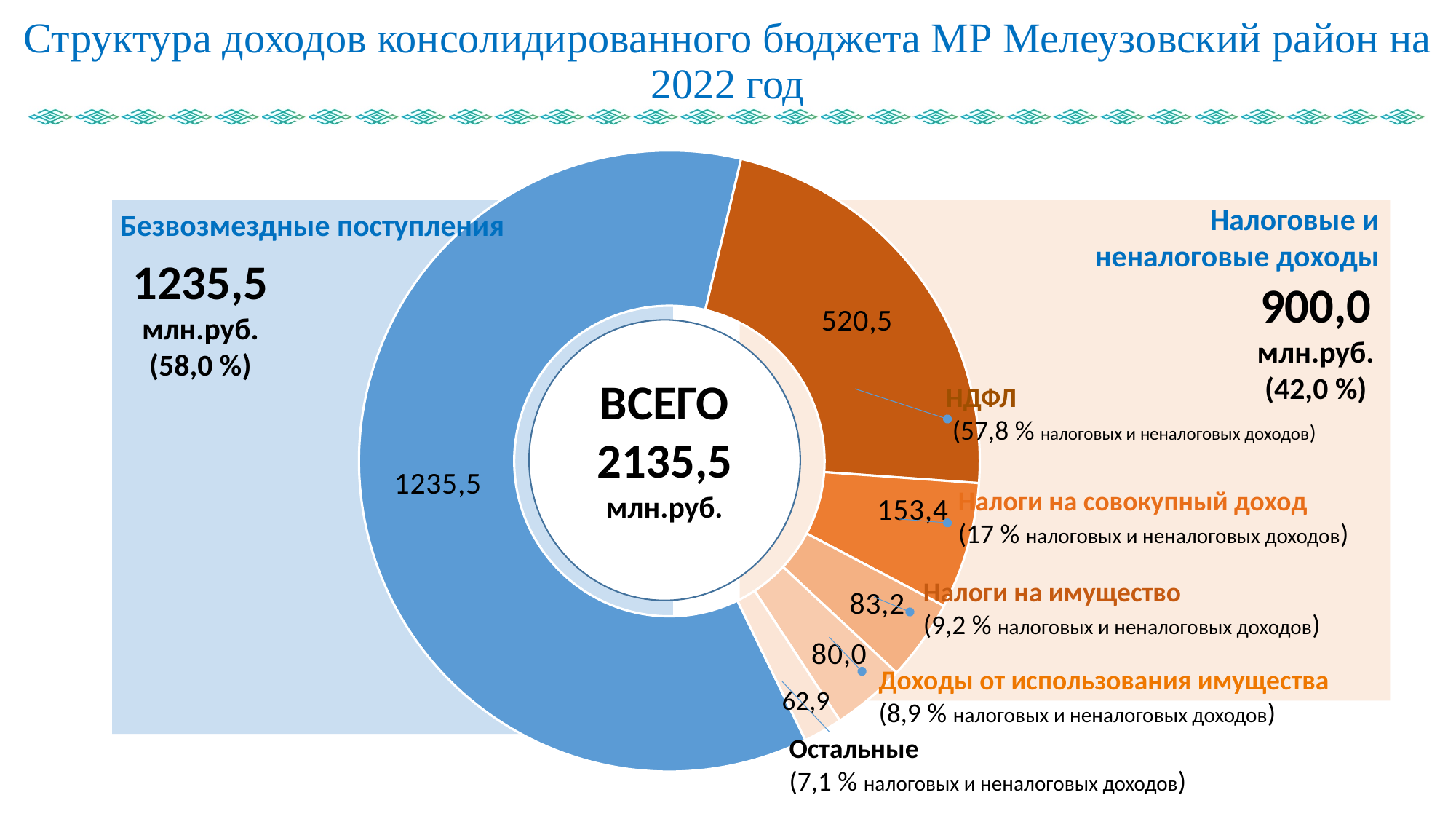
What kind of chart is shown on the slide? doughnut (pie) chart What is the value shown for Доходы от использования имущества? 80,0 What is the value shown for НДФЛ? 520,5 What total value (ВСЕГО) is shown in the centre of the chart? 2135,5 млн.руб. What is the difference between the values for НДФЛ and Налоги на совокупный доход? 367,1 What share of the total do Безвозмездные поступления make up, as shown on the slide? 58,0 % What is the value shown for Налоги на совокупный доход? 153,4 Which segment of the chart is the largest? Безвозмездные поступления What is the value shown for Остальные? 62,9 What is the value shown for Безвозмездные поступления? 1235,5 Which is larger: Налоги на имущество or Доходы от использования имущества? Налоги на имущество Which segment of the chart is the smallest? Остальные